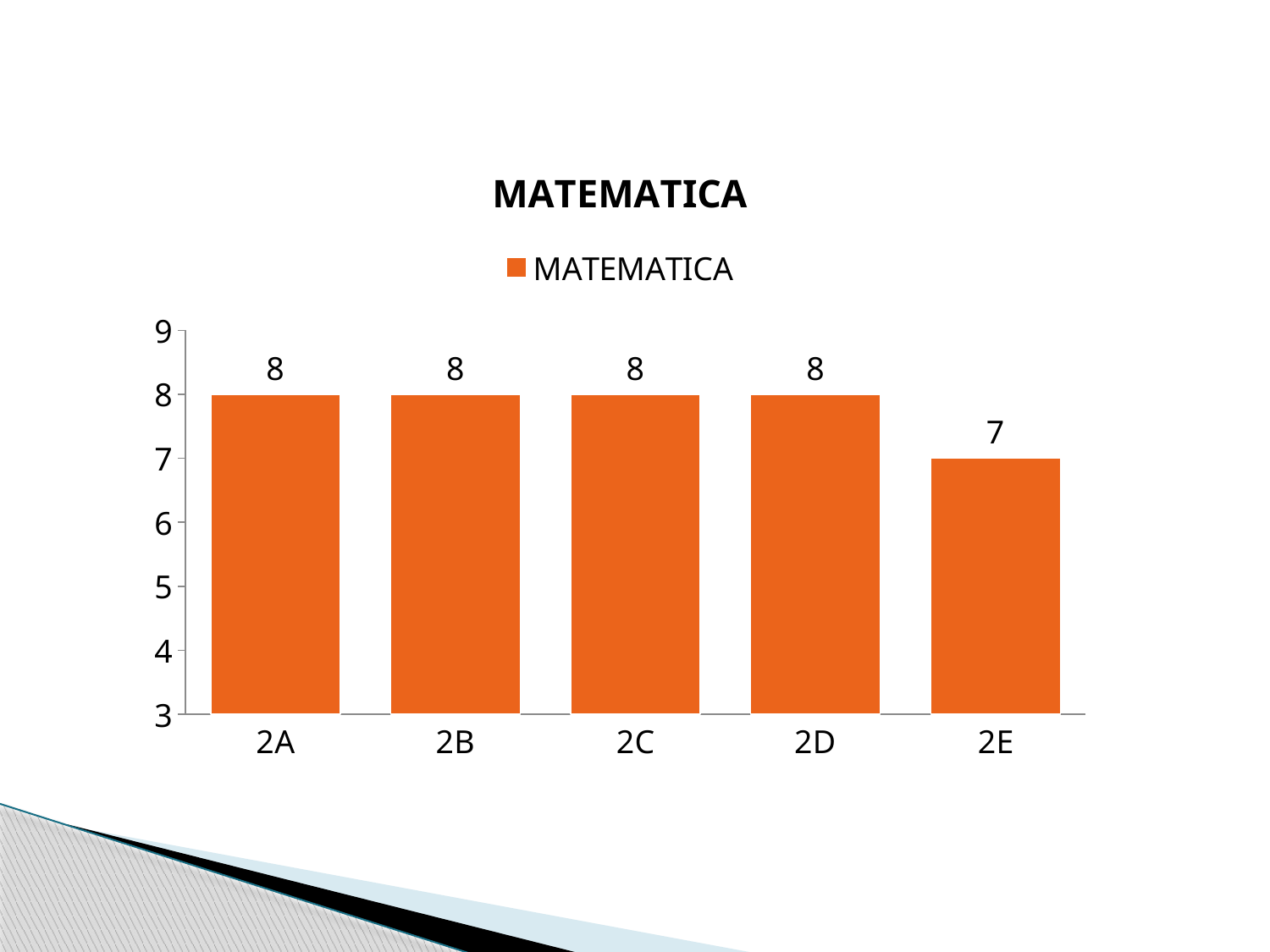
How many categories are shown on the x axis? 5 What is the value for 2E? 7 What kind of chart is shown? bar chart Which is larger, the value for 2B or the value for 2E? 2B How many series does the legend list? 1 Is the value for 2E greater or less than 8? less What is the value for 2A? 8 What is the difference between the values for 2D and 2E? 1 Which category has the lowest value? 2E What is the value for 2C? 8 What colour are the bars? orange What is the title of the chart? MATEMATICA